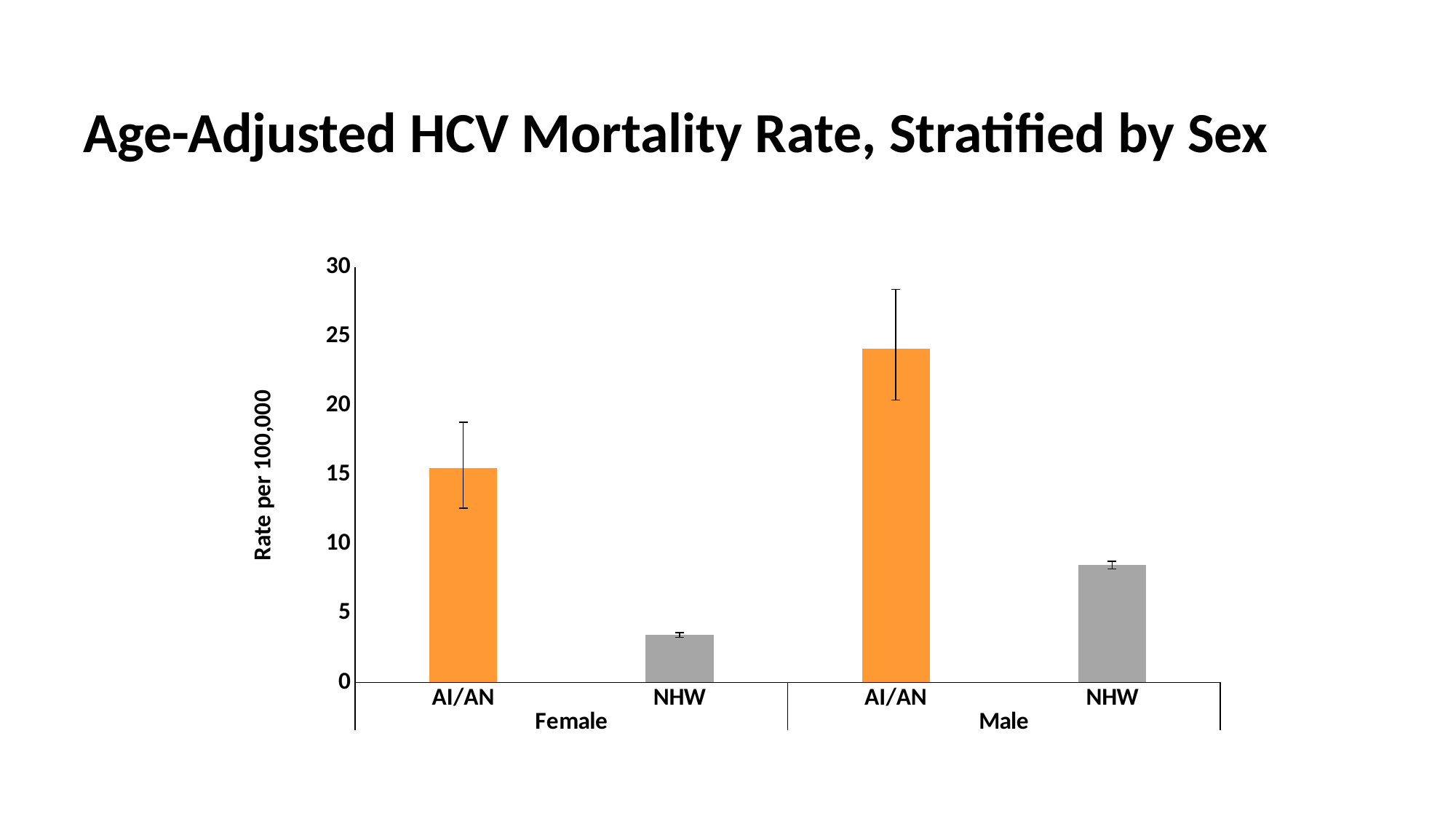
What kind of chart is shown on the slide? bar chart What is the label on the vertical axis of the chart? Rate per 100,000 What is the title of the chart on the slide? Age-Adjusted HCV Mortality Rate, Stratified by Sex Is the value for Male NHW greater or less than 10? less Which bar has the highest value in the chart? Male AI/AN Is the value for Female NHW greater or less than 5? less Which is larger, the value for Female AI/AN or the value for Female NHW? Female AI/AN Which is larger, the value for Male NHW or the value for Female AI/AN? Female AI/AN Is the value for Male AI/AN greater or less than 20? greater Which bar has the lowest value in the chart? Female NHW How many bars are plotted in the chart? 4